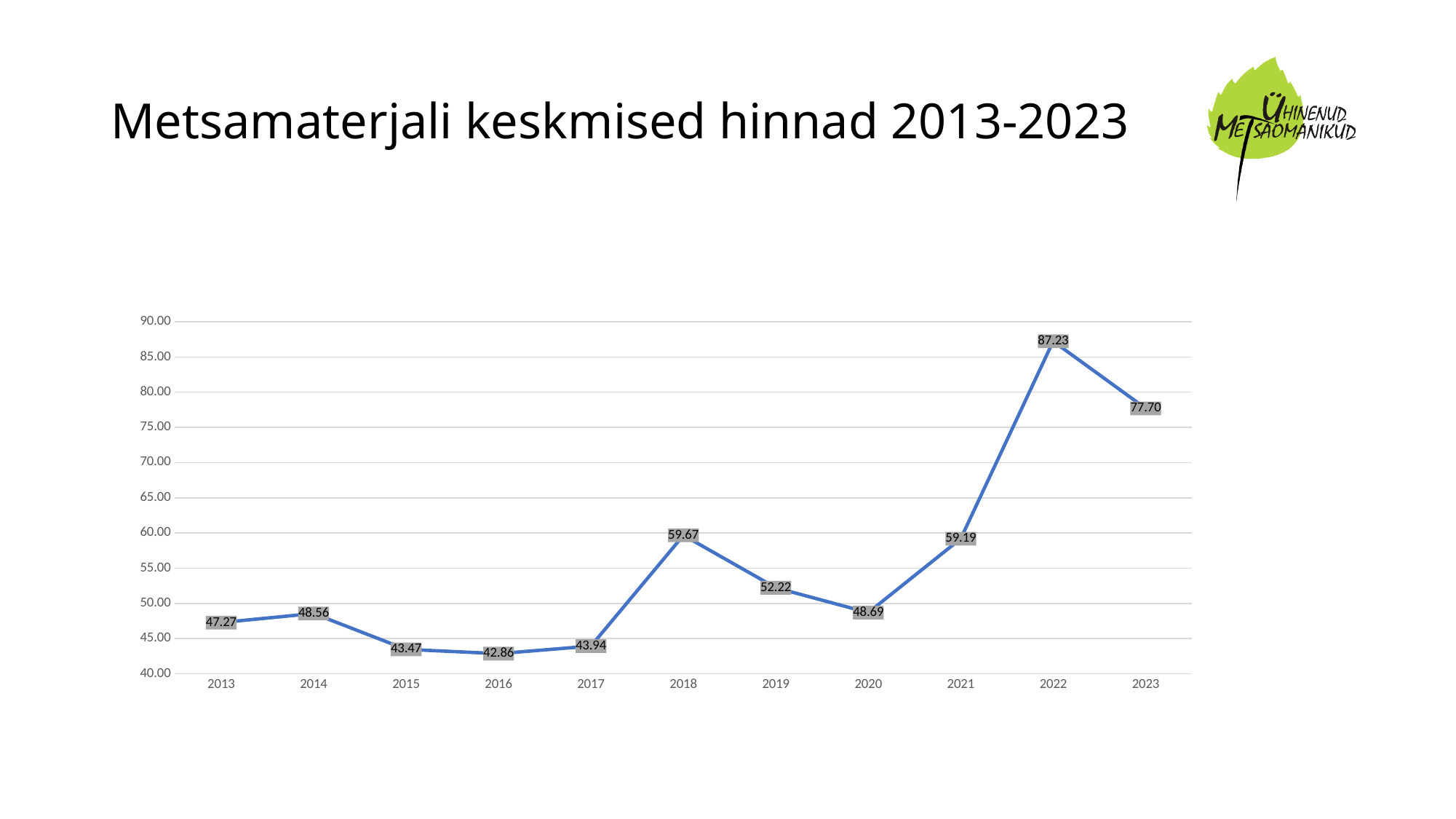
Which year has the highest value? 2022 What is the title of the slide? Metsamaterjali keskmised hinnad 2013-2023 What is the value for 2013? 47.27 Which year has the lowest value? 2016 What kind of chart is shown on the slide? line chart How many years are plotted on the x axis? 11 What is the value for 2018? 59.67 Is the value for 2021 greater or less than 55.00? greater What is the value for 2023? 77.70 What is the difference between the values for 2022 and 2023? 9.53 What is the difference between the values for 2021 and 2020? 10.50 Which is larger, the value for 2014 or the value for 2019? 2019